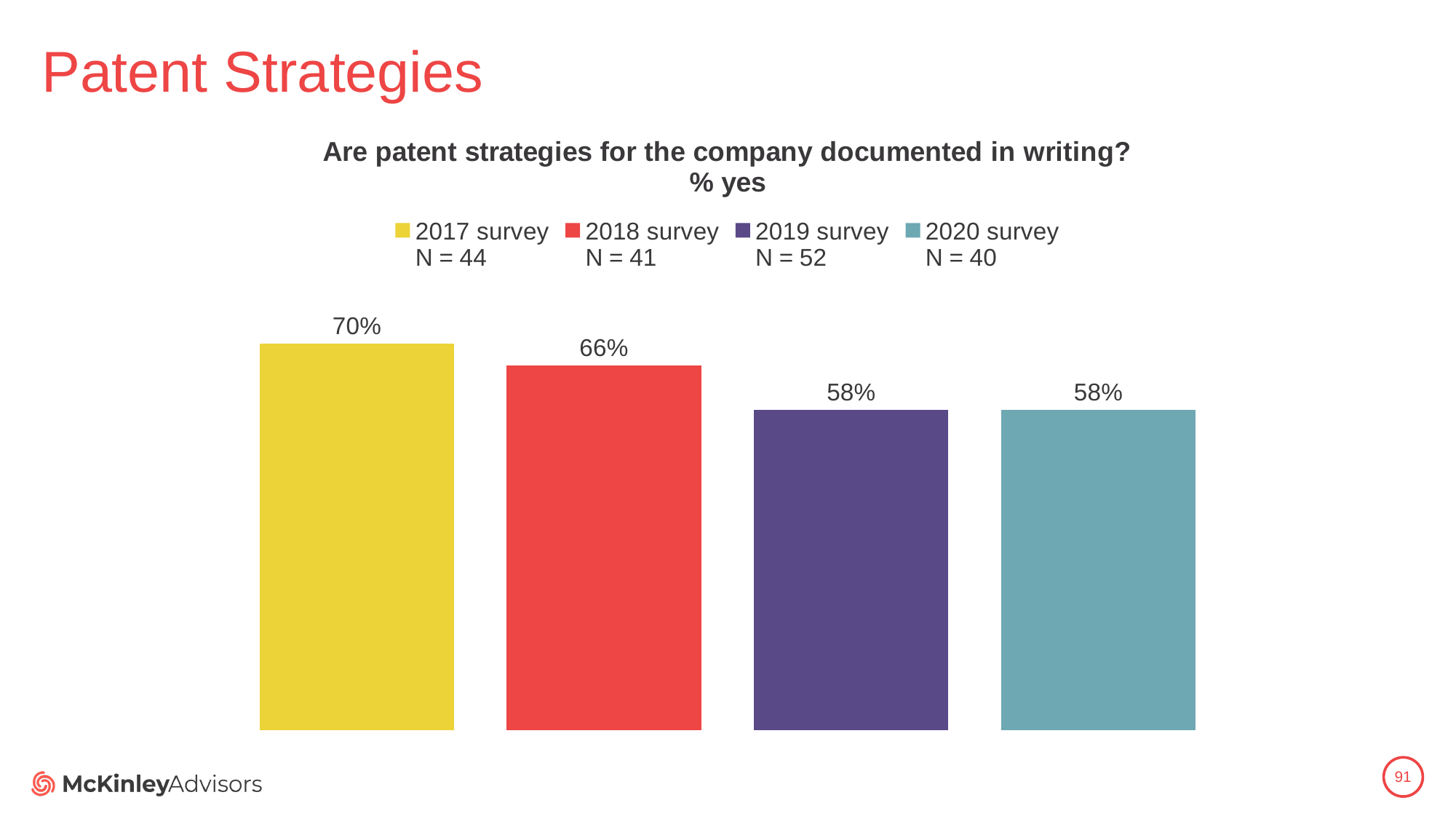
What is the value shown for the 2018 survey? 66% What is the difference in percentage points between the 2018 survey and the 2019 survey? 8 What is the value shown for the 2019 survey? 58% Which survey year has the highest percentage of yes responses? 2017 survey Do the values rise or fall from the 2017 survey to the 2020 survey? Fall How many series does the legend list? 4 What is the difference in percentage points between the 2017 survey and the 2020 survey? 12 What percentage of respondents in the 2017 survey said patent strategies are documented in writing? 70% What is the value shown for the 2020 survey? 58% What kind of chart is shown on the slide? Bar chart Which is larger, the value for the 2017 survey or the 2018 survey? 2017 survey How many survey years are plotted in the chart? 4